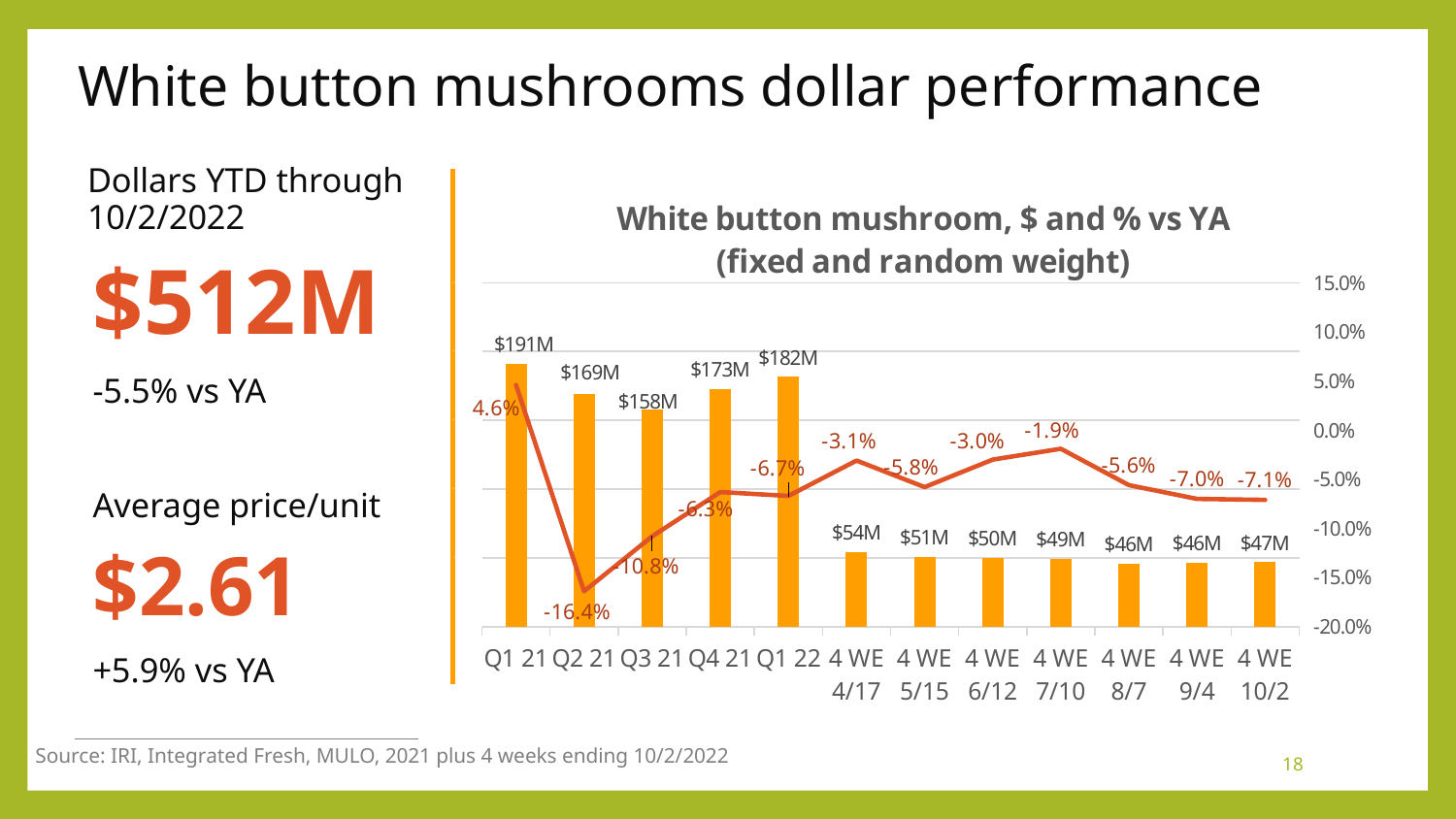
What kind of chart is this? Combination bar and line chart How many periods are shown on the x axis? 12 What is the dollar value shown for 4 WE 10/2? $47M Which has the larger dollar value, Q4 21 or Q1 22? Q1 22 What is the difference in dollars between Q1 21 and Q2 21? $22M What is the title of the chart? White button mushroom, $ and % vs YA (fixed and random weight) What is the difference in dollars between 4 WE 4/17 and 4 WE 10/2? $7M What is the % vs YA value shown for Q2 21? -16.4% What is the % vs YA value shown for 4 WE 7/10? -1.9% Which period has the lowest % vs YA value on the line? Q2 21 Which period has the highest dollar bar? Q1 21 What is the dollar value shown for Q1 21? $191M